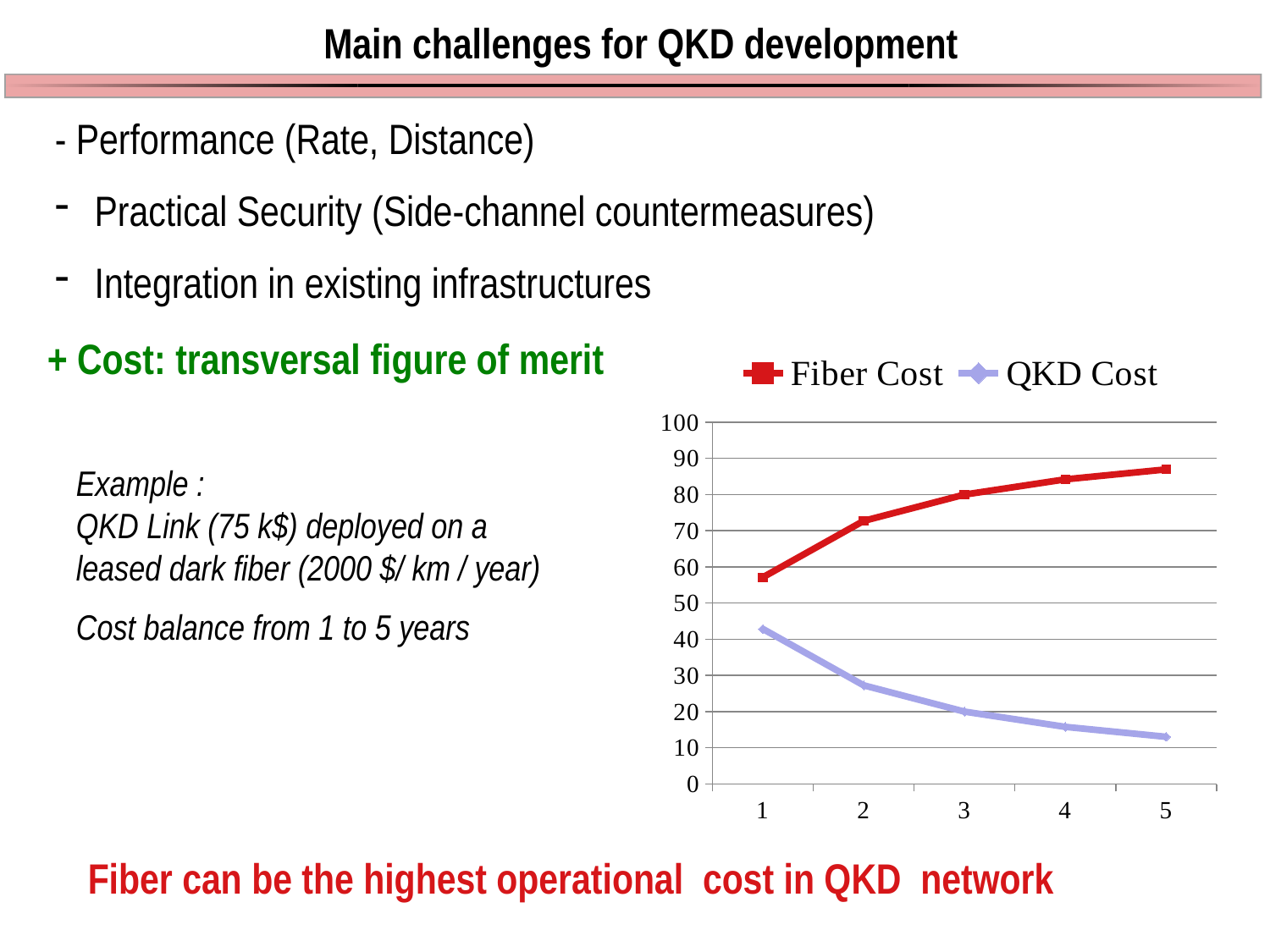
At year 1, which is larger: Fiber Cost or QKD Cost? Fiber Cost Is the QKD Cost at year 1 greater or less than 50? less What colour is the Fiber Cost line in the chart? red Does the Fiber Cost series rise or fall from year 1 to year 5? rise Does the QKD Cost series rise or fall from year 1 to year 5? fall At which year is the QKD Cost lowest? 5 Is the Fiber Cost at year 1 greater or less than 50? greater At which year is the Fiber Cost highest? 5 How many points along the x axis does each series have? 5 Is the QKD Cost at year 5 greater or less than 20? less How many series does the chart legend list? 2 What kind of chart is shown on the slide? line chart